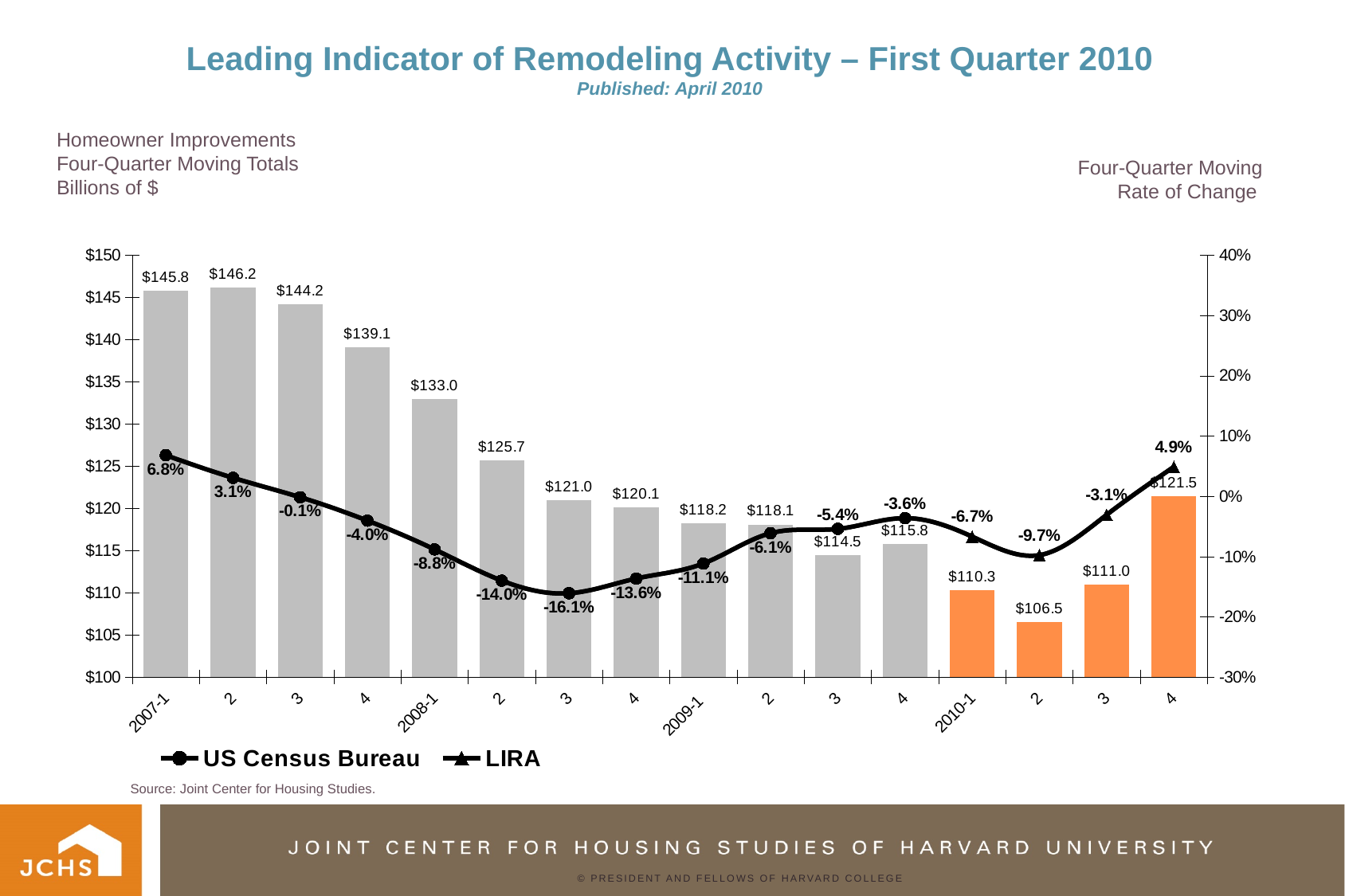
How many series does the legend list? 2 What is the four-quarter moving total for 2008-1? $133.0 Which quarter has the lowest four-quarter moving rate of change on the line? 2008-3 What is the four-quarter moving rate of change shown for 2008-3? -16.1% What is the difference between the four-quarter moving totals for 2007-1 and 2010-4? $24.3 Which quarter has the highest four-quarter moving total bar? 2007-2 Do the four-quarter moving total bars rise or fall from 2007-1 to 2010-2? Fall How many quarterly bars are plotted on the chart? 16 Which quarter has the lowest four-quarter moving total bar? 2010-2 What is the LIRA rate of change shown for 2010-4? 4.9% Which has the larger four-quarter moving total, 2009-3 or 2009-4? 2009-4 What kind of chart is shown on the slide? Combined bar and line chart